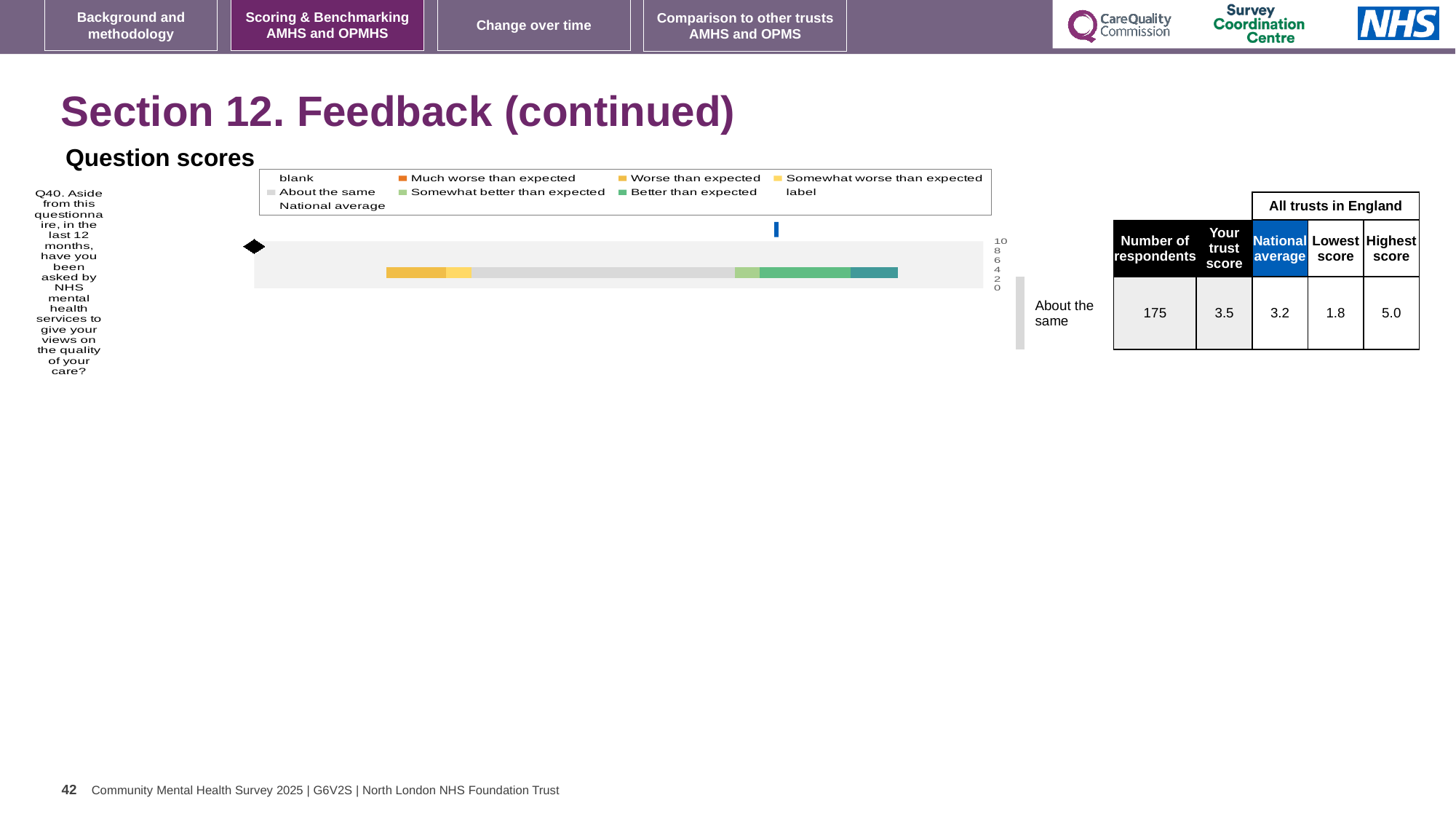
In the table beside the chart, what is the Lowest score among all trusts in England for Q40? 1.8 For Q40, what is the difference between the Highest score and the Lowest score among all trusts in England? 3.2 How many questions are plotted in the Question scores chart? 1 For Q40, which is larger: the trust score or the National average? the trust score Which question number is plotted in the Question scores chart? Q40 What benchmark category label is shown to the right of the Q40 bar? About the same In the table beside the chart, what is the number of respondents for Q40? 175 For Q40, what is the difference between the trust score and the National average? 0.3 In the table beside the chart, what is the Highest score among all trusts in England for Q40? 5.0 In the table beside the chart, what is the National average for Q40? 3.2 What kind of chart is shown under 'Question scores'? bar chart In the table beside the chart, what is 'Your trust score' for Q40? 3.5